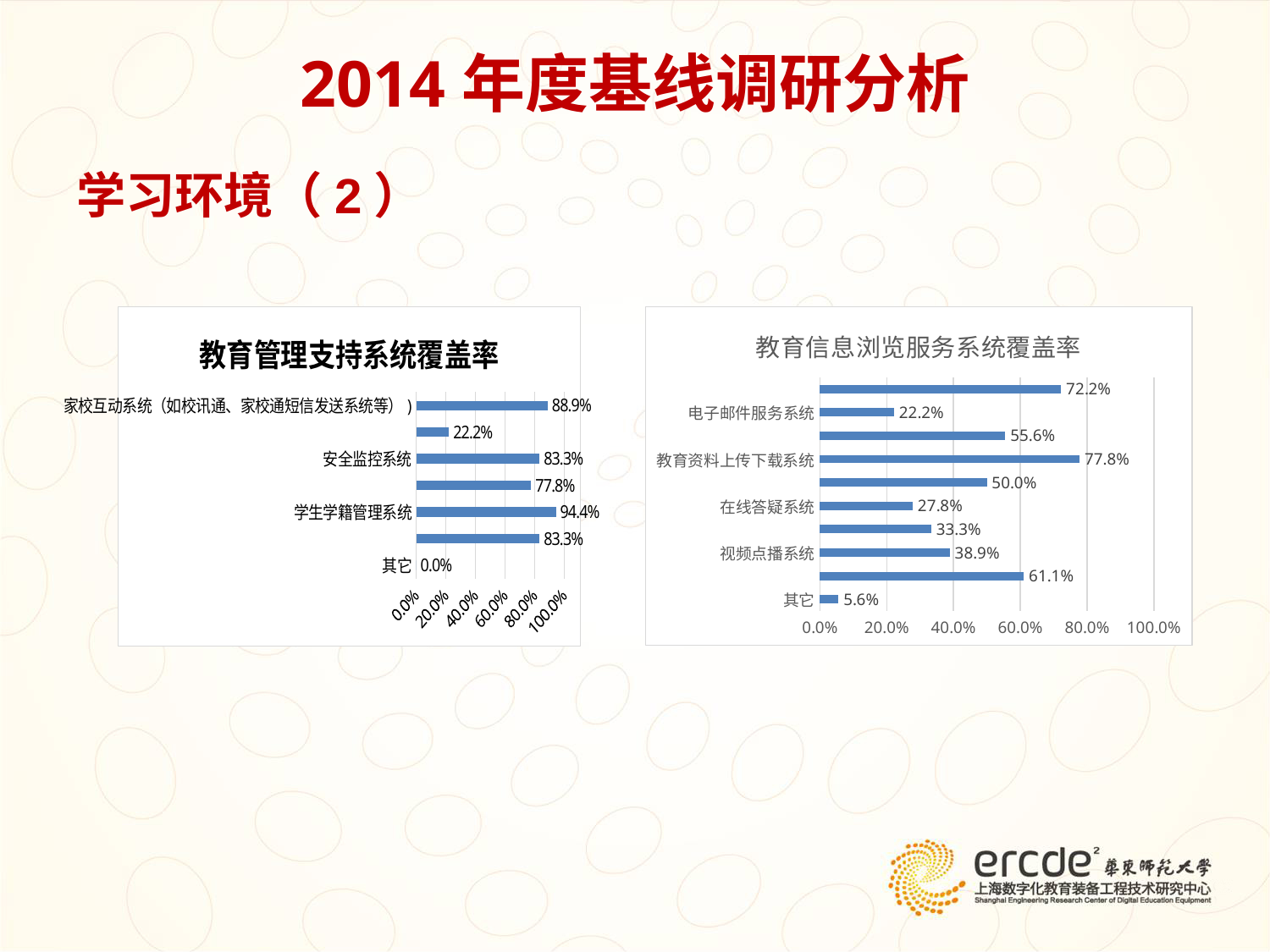
In the chart titled 教育管理支持系统覆盖率, what is the difference between the values for 学生学籍管理系统 and 安全监控系统? 11.1% In the chart titled 教育管理支持系统覆盖率, which category has the highest value? 学生学籍管理系统 In the chart titled 教育信息浏览服务系统覆盖率, which category has the lowest value? 其它 In the chart titled 教育管理支持系统覆盖率, what is the value for 学生学籍管理系统? 94.4% In the chart titled 教育管理支持系统覆盖率, how many bars are plotted? 7 In the chart titled 教育信息浏览服务系统覆盖率, what is the value for 视频点播系统? 38.9% In the chart titled 教育信息浏览服务系统覆盖率, which is larger, the value for 电子邮件服务系统 or the value for 在线答疑系统? 在线答疑系统 In the chart titled 教育管理支持系统覆盖率, which category has the lowest value? 其它 In the chart titled 教育信息浏览服务系统覆盖率, how many bars are plotted? 10 In the chart titled 教育管理支持系统覆盖率, what is the value for 安全监控系统? 83.3% What kind of chart is the chart titled 教育信息浏览服务系统覆盖率? Bar chart In the chart titled 教育信息浏览服务系统覆盖率, what is the value for 教育资料上传下载系统? 77.8%